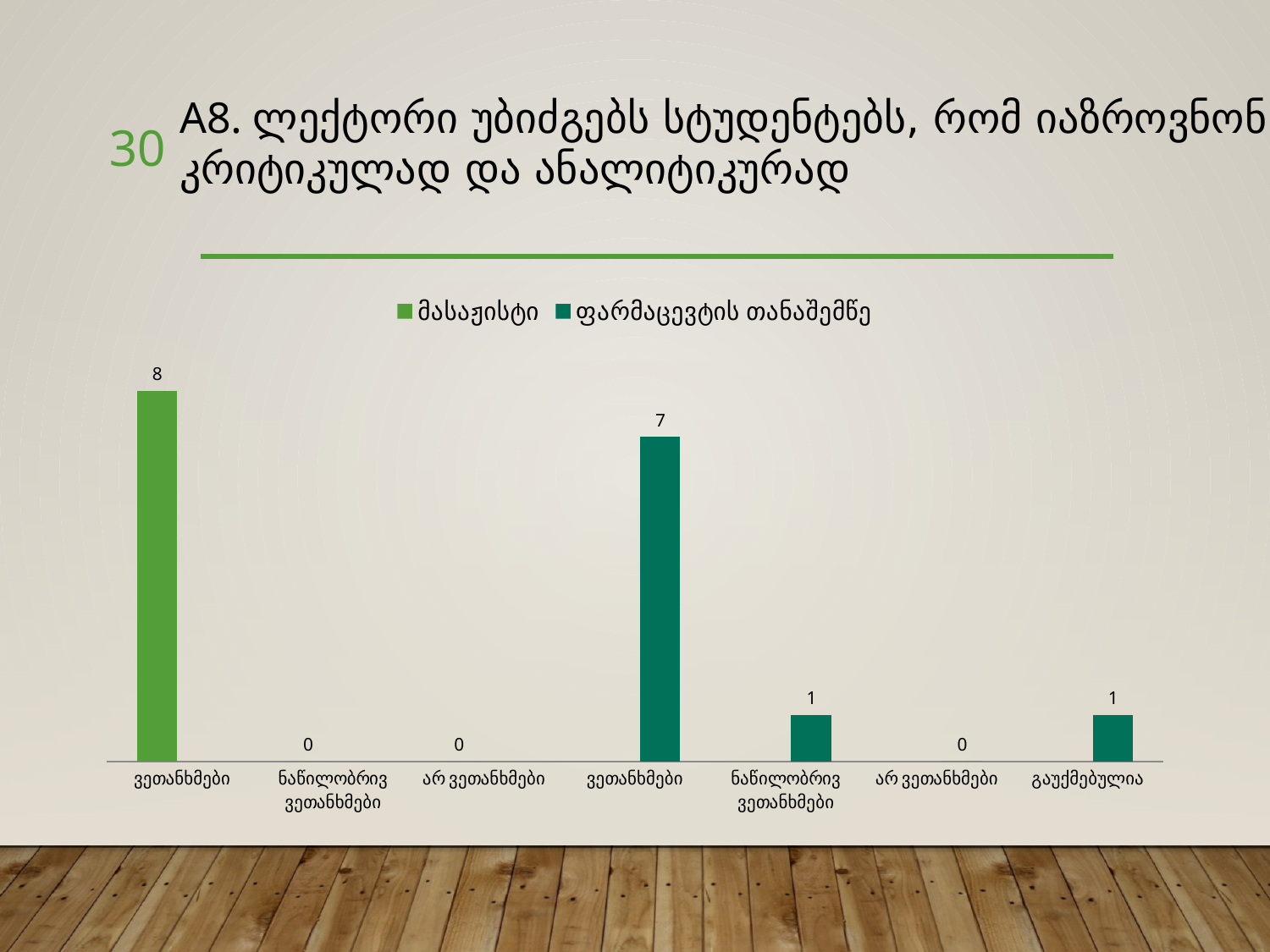
What is the value of the გაუქმებულია bar? 1 What is the value of the ვეთანხმები bar for the ფარმაცევტის თანაშემწე series? 7 What is the value of the ვეთანხმები bar for the მასაჟისტი series? 8 How many bars on the chart have a value of 0? 3 What is the value of the ნაწილობრივ ვეთანხმები bar for the ფარმაცევტის თანაშემწე series? 1 How many series does the legend list? 2 Which bar has the highest value on the chart? ვეთანხმები (მასაჟისტი) What type of chart is shown on the slide? bar chart What are the two series named in the legend? მასაჟისტი and ფარმაცევტის თანაშემწე Which is larger: the ვეთანხმები bar for მასაჟისტი or the ვეთანხმები bar for ფარმაცევტის თანაშემწე? ვეთანხმები for მასაჟისტი What is the value of the არ ვეთანხმები bar for the მასაჟისტი series? 0 What is the difference between the ვეთანხმები value for მასაჟისტი and the ვეთანხმები value for ფარმაცევტის თანაშემწე? 1